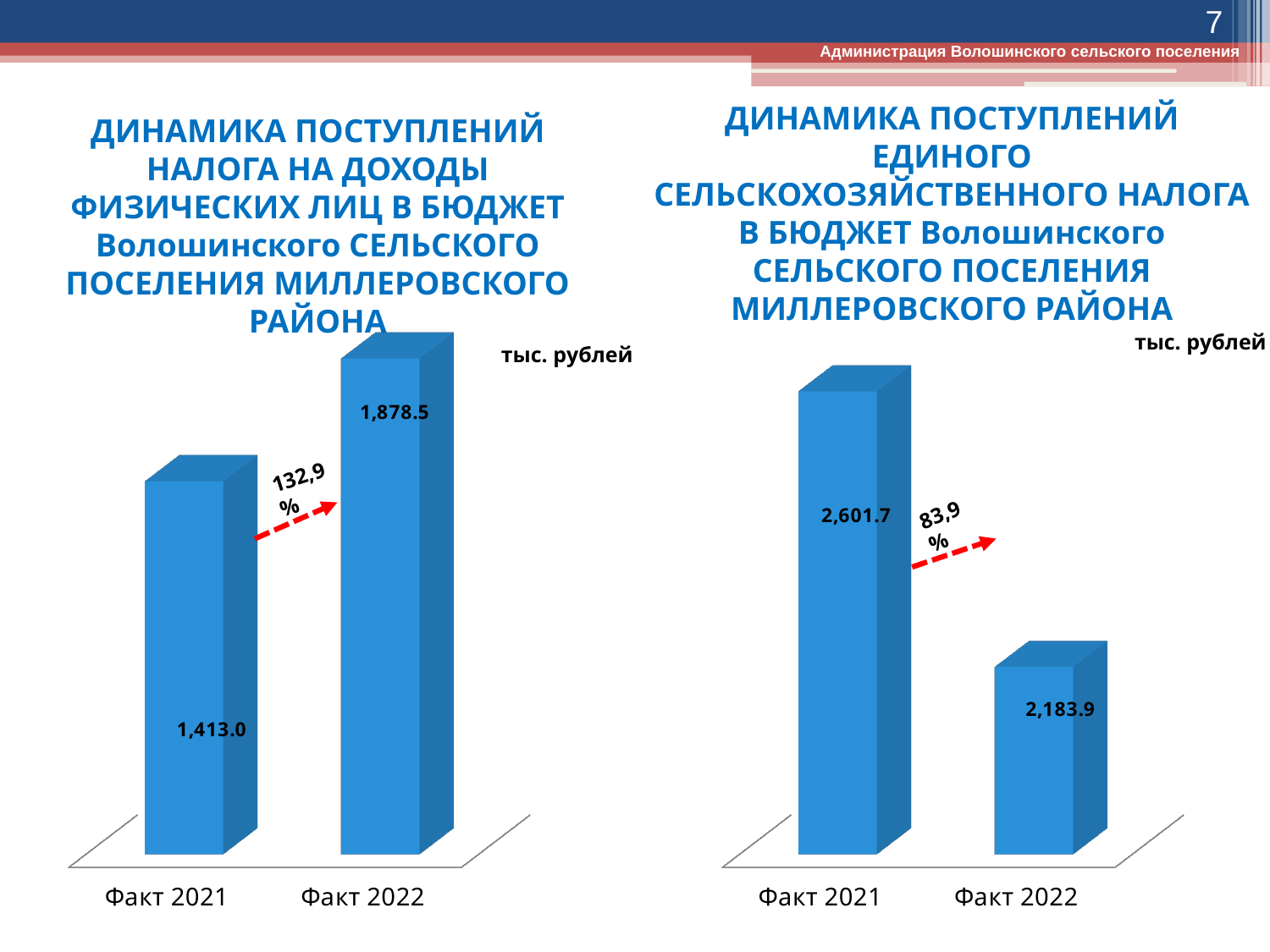
On the left chart, how many categories are shown? 2 On the left chart (налог на доходы физических лиц), what is the value for Факт 2022? 1,878.5 On the left chart (налог на доходы физических лиц), what is the value for Факт 2021? 1,413.0 On the left chart, what percentage is shown next to the arrow between the bars? 132,9 % On the right chart (единый сельскохозяйственный налог), what is the value for Факт 2022? 2,183.9 On the left chart, which category has the higher value? Факт 2022 On the right chart, what is the difference between Факт 2021 and Факт 2022? 417.8 On the left chart, what is the difference between Факт 2022 and Факт 2021? 465.5 On the right chart, do the values rise or fall from Факт 2021 to Факт 2022? fall On the right chart (единый сельскохозяйственный налог), what is the value for Факт 2021? 2,601.7 On the right chart, which category has the lower value? Факт 2022 What type of chart is the right chart? bar chart